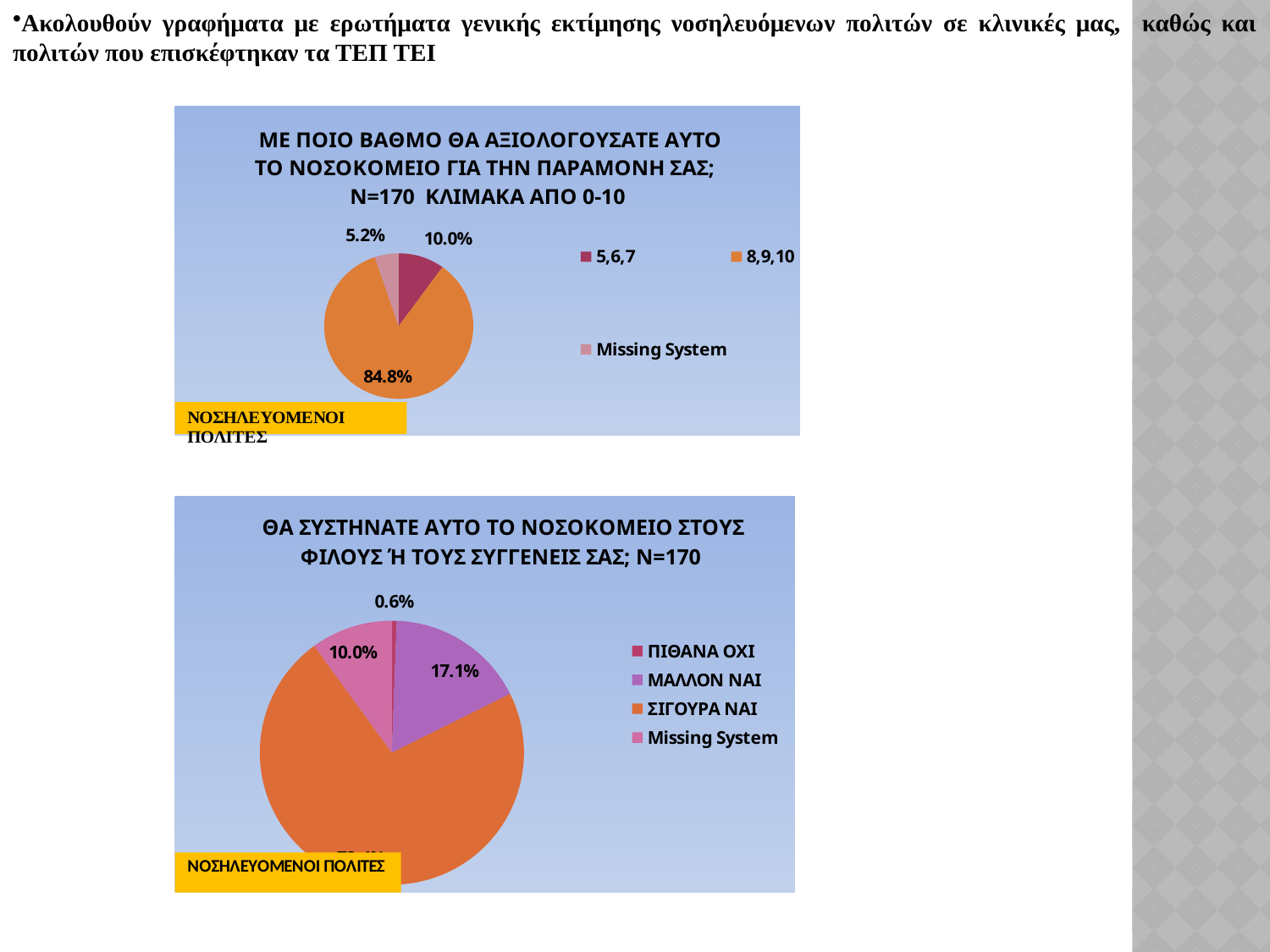
In the bottom chart, what percentage is shown for ΠΙΘΑΝΑ ΟΧΙ? 0.6% In the top chart, what percentage is shown for the 5,6,7 category? 10.0% In the top chart, what is the difference between the 8,9,10 share and the 5,6,7 share? 74.8% How many entries does the legend of the bottom chart list? 4 How many entries does the legend of the top chart list? 3 What type of chart is the bottom chart (ΘΑ ΣΥΣΤΗΝΑΤΕ ΑΥΤΟ ΤΟ ΝΟΣΟΚΟΜΕΙΟ)? Pie chart In the top chart (ΜΕ ΠΟΙΟ ΒΑΘΜΟ ΘΑ ΑΞΙΟΛΟΓΟΥΣΑΤΕ ΑΥΤΟ ΤΟ ΝΟΣΟΚΟΜΕΙΟ), what share of respondents gave a rating of 8,9,10? 84.8% In the top chart, which category has the smallest slice? Missing System In the top chart, which category has the largest slice? 8,9,10 In the top chart, what percentage is labelled Missing System? 5.2% In the bottom chart, what percentage is shown for ΜΑΛΛΟΝ ΝΑΙ? 17.1% In the bottom chart, which is larger: ΜΑΛΛΟΝ ΝΑΙ or Missing System? ΜΑΛΛΟΝ ΝΑΙ